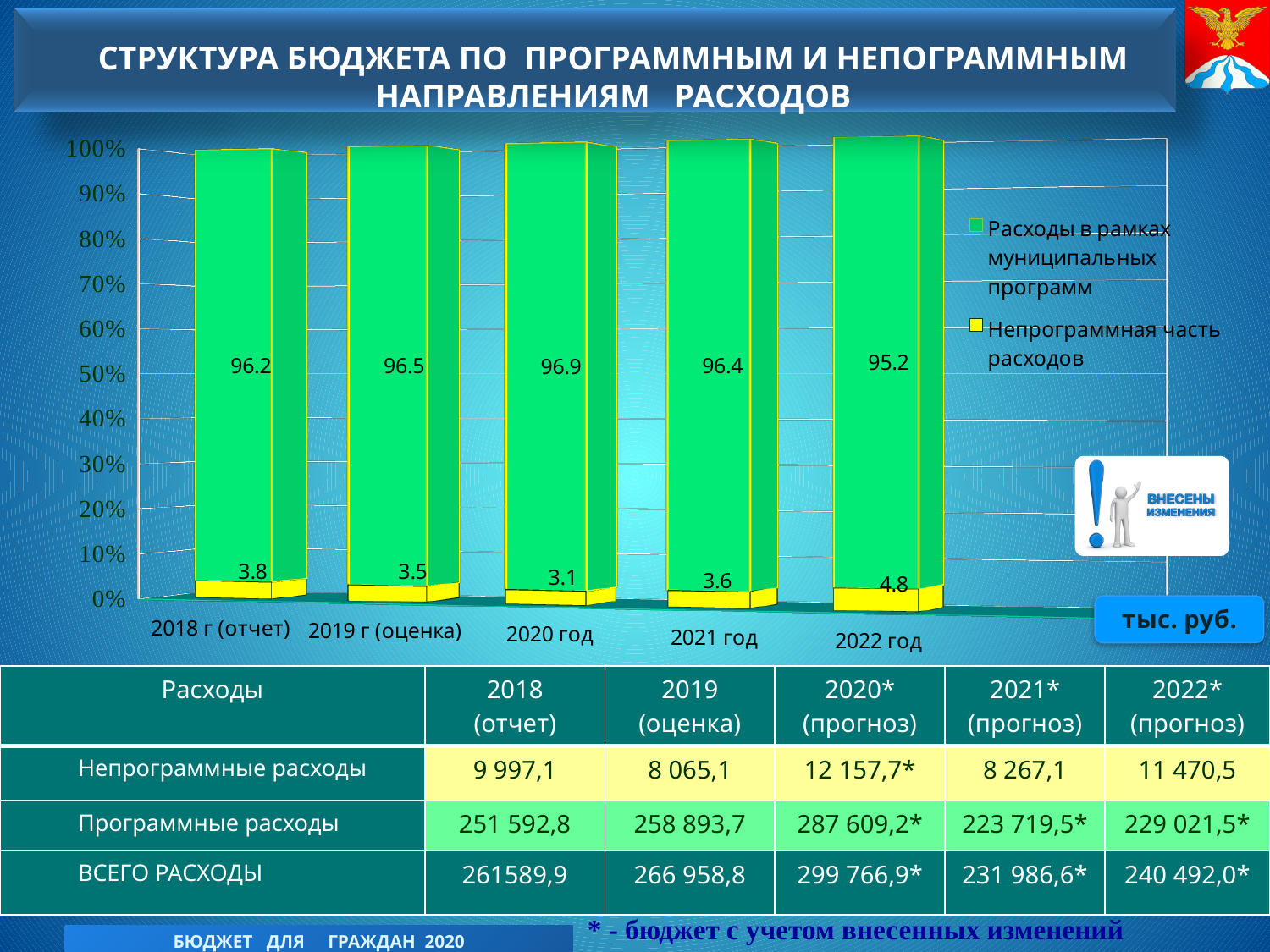
In which year is 'Непрограммная часть расходов' lowest? 2020 год What is the value of 'Расходы в рамках муниципальных программ' for 2018 г (отчет)? 96.2 Which is larger: 'Расходы в рамках муниципальных программ' for 2019 г (оценка) or for 2022 год? 2019 г (оценка) Does 'Непрограммная часть расходов' rise or fall from 2020 год to 2022 год? rise What is the difference between the 'Непрограммная часть расходов' values for 2022 год and 2018 г (отчет)? 1.0 How many year categories are plotted on the chart? 5 How many series does the chart legend list? 2 What is the value of 'Непрограммная часть расходов' for 2020 год? 3.1 What is the value of 'Непрограммная часть расходов' for 2022 год? 4.8 What type of chart is shown on the slide? bar chart In which year is 'Расходы в рамках муниципальных программ' highest? 2020 год Which colour represents 'Непрограммная часть расходов' in the chart? yellow